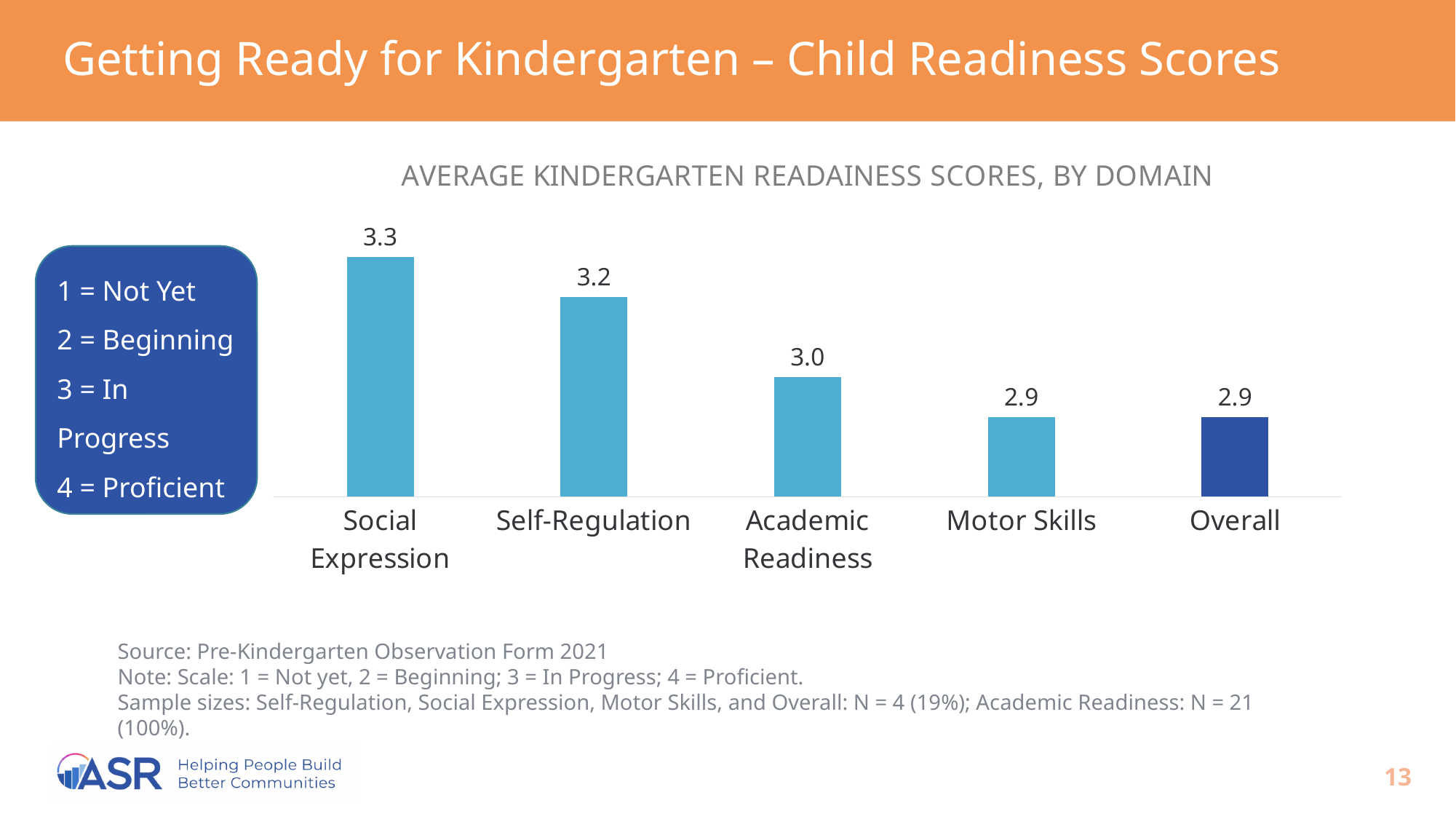
How many categories are shown on the x axis of the chart? 5 What is the average score for Self-Regulation? 3.2 What is the difference between the Social Expression score and the Motor Skills score? 0.4 What is the difference between the Self-Regulation score and the Academic Readiness score? 0.2 What kind of chart is shown on the slide? Bar chart Which domain has the highest average readiness score? Social Expression Do the scores rise or fall from Social Expression to Motor Skills along the x axis? Fall What is the average kindergarten readiness score for Social Expression? 3.3 What is the title of the chart? AVERAGE KINDERGARTEN READAINESS SCORES, BY DOMAIN What is the Overall average readiness score? 2.9 Which is larger, the score for Self-Regulation or the score for Academic Readiness? Self-Regulation What is the average score for Academic Readiness? 3.0